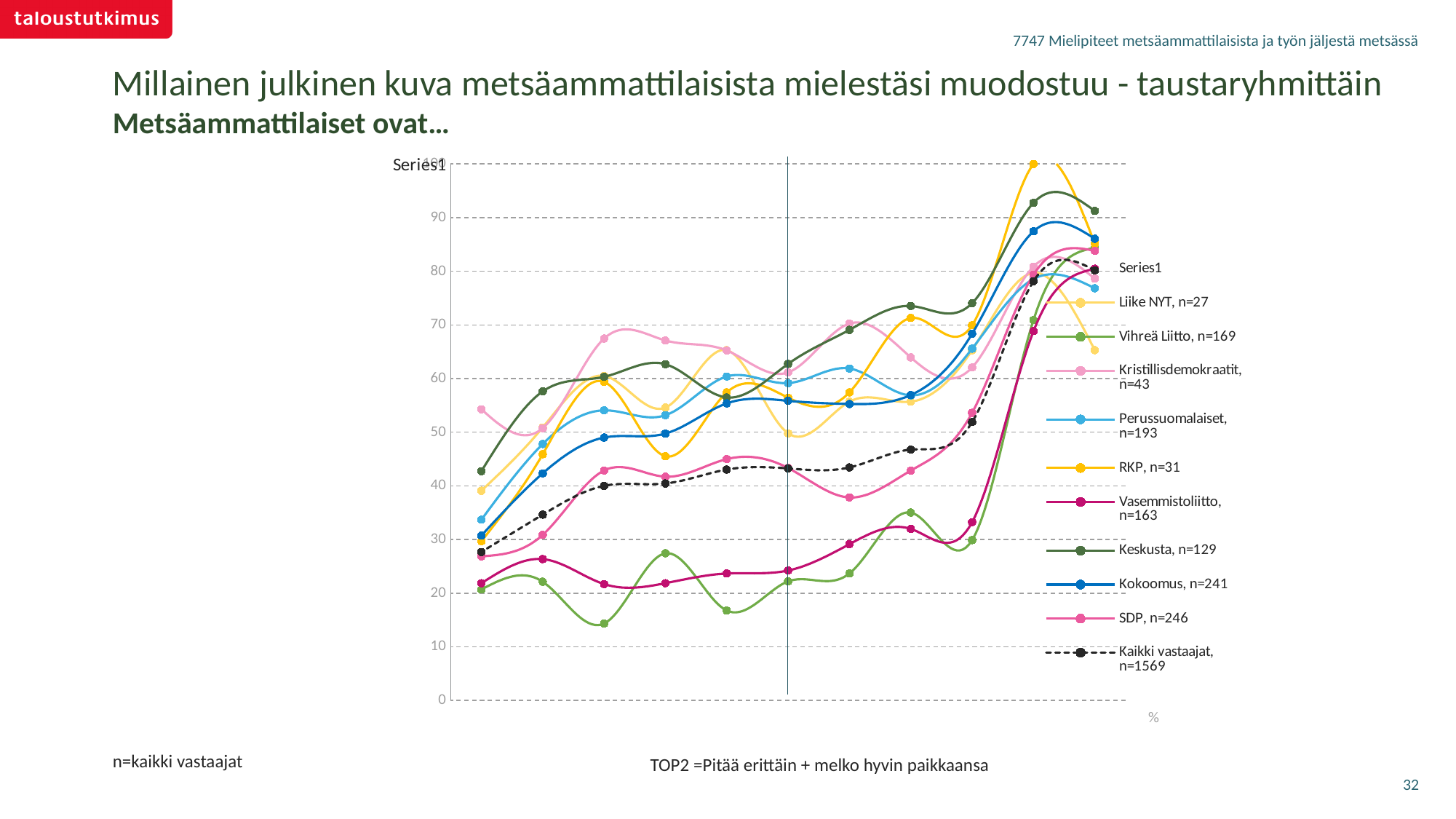
What kind of chart is shown on the slide? line chart Does the dashed 'Kaikki vastaajat, n=1569' line rise or fall overall from its first point to its last point? rise What is the highest value shown on the vertical axis? 100 Which series reaches the lowest value anywhere on the chart? Vihreä Liitto, n=169 How many data points does each line on the chart have? 11 Is the value of the first point of the 'Vasemmistoliitto, n=163' line greater or less than 30? less What sample size (n) does the legend give for Kokoomus? 241 Which series reaches the highest value anywhere on the chart? RKP, n=31 Is the value of the last point of the 'Kaikki vastaajat, n=1569' line greater or less than 70? greater At the last data point, which is larger: the value for 'Keskusta, n=129' or the value for 'Vihreä Liitto, n=169'? Keskusta, n=129 How many series does the legend list? 11